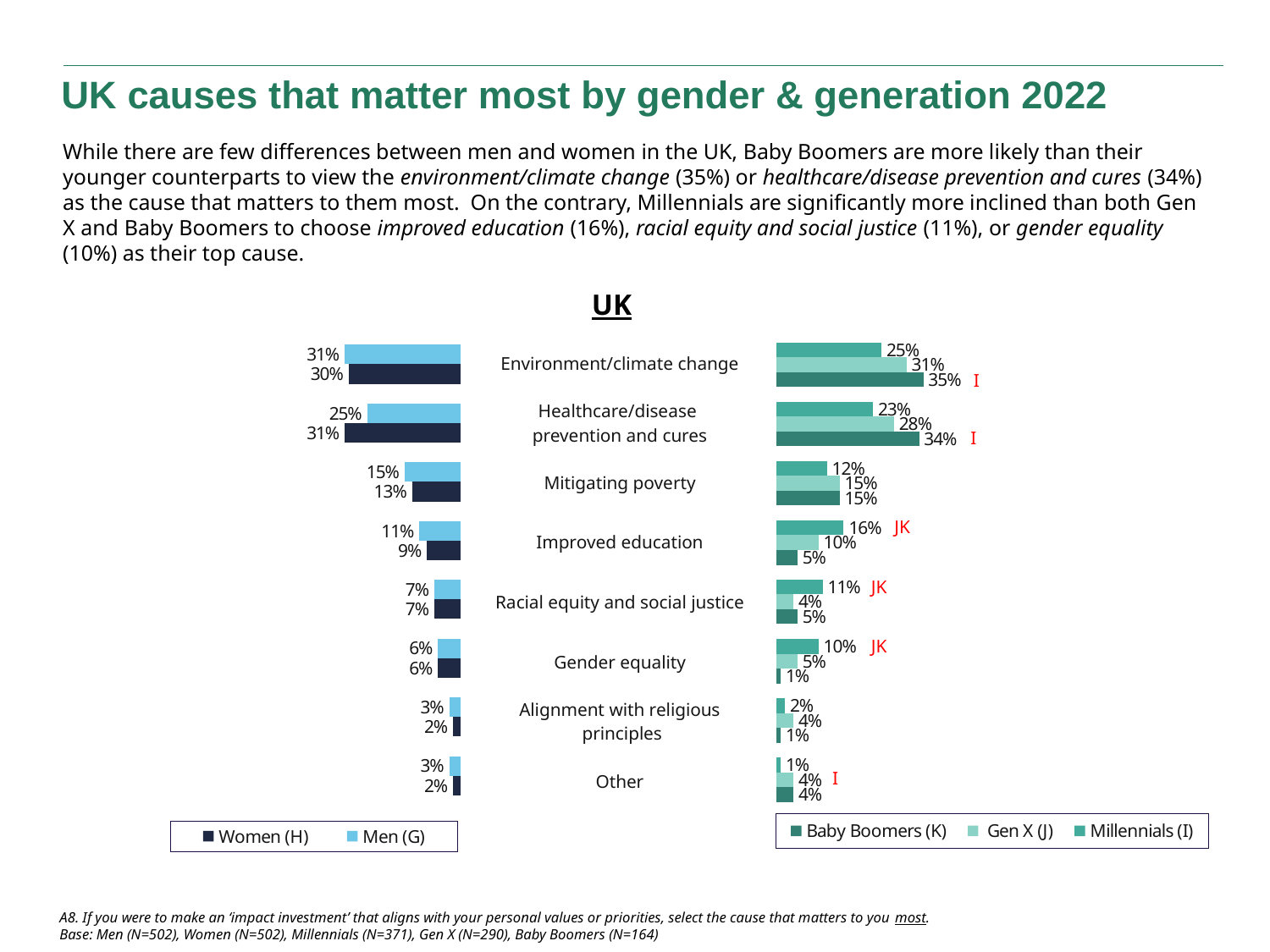
In the left chart (gender), what is the difference between women and men for Healthcare/disease prevention and cures? 6 percentage points In the right chart (generation), which generation has the highest value for Gender equality? Millennials (I) In the right chart (generation), what percentage of Millennials chose Improved education? 16% How many series does the legend of the right chart (generation) list? 3 How many causes (categories) are shown on the slide? 8 In the right chart (generation), what is the difference between Baby Boomers and Millennials for Environment/climate change? 10 percentage points What kind of chart is used on the slide? Bar chart In the right chart (generation), what percentage of Baby Boomers chose Environment/climate change? 35% In the right chart (generation), is the value for Gen X or Baby Boomers larger for Healthcare/disease prevention and cures? Baby Boomers In the left chart (gender), which cause has the lowest value for women? Alignment with religious principles and Other (both 2%) In the left chart (gender), what percentage of women chose Healthcare/disease prevention and cures? 31% In the left chart (gender), what percentage of men chose Environment/climate change? 31%